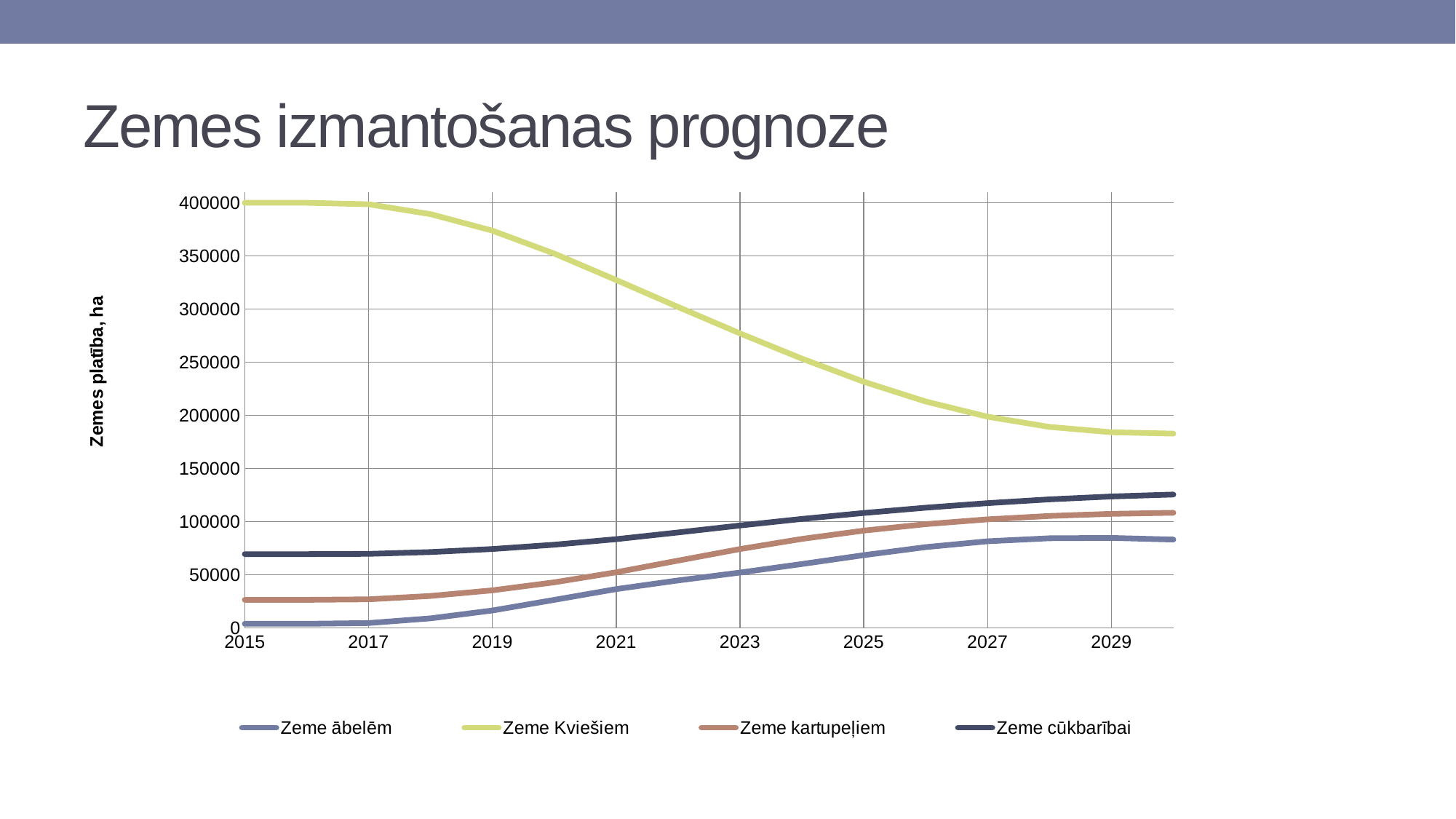
In 2029, which is larger: Zeme cūkbarībai or Zeme kartupeļiem? Zeme cūkbarībai Is the value for Zeme ābelēm in 2015 greater or less than 50000? less Is the value for Zeme cūkbarībai in 2015 greater or less than 50000? greater Does the value for Zeme cūkbarībai rise or fall from 2015 to 2029? rise Is the value for Zeme Kviešiem in 2021 greater or less than 300000? greater How many series does the legend list? 4 What kind of chart is shown on the slide? line chart Does the value for Zeme Kviešiem rise or fall from 2015 to 2029? fall Which series has the highest value in 2015? Zeme Kviešiem What is the title of the vertical axis? Zemes platība, ha